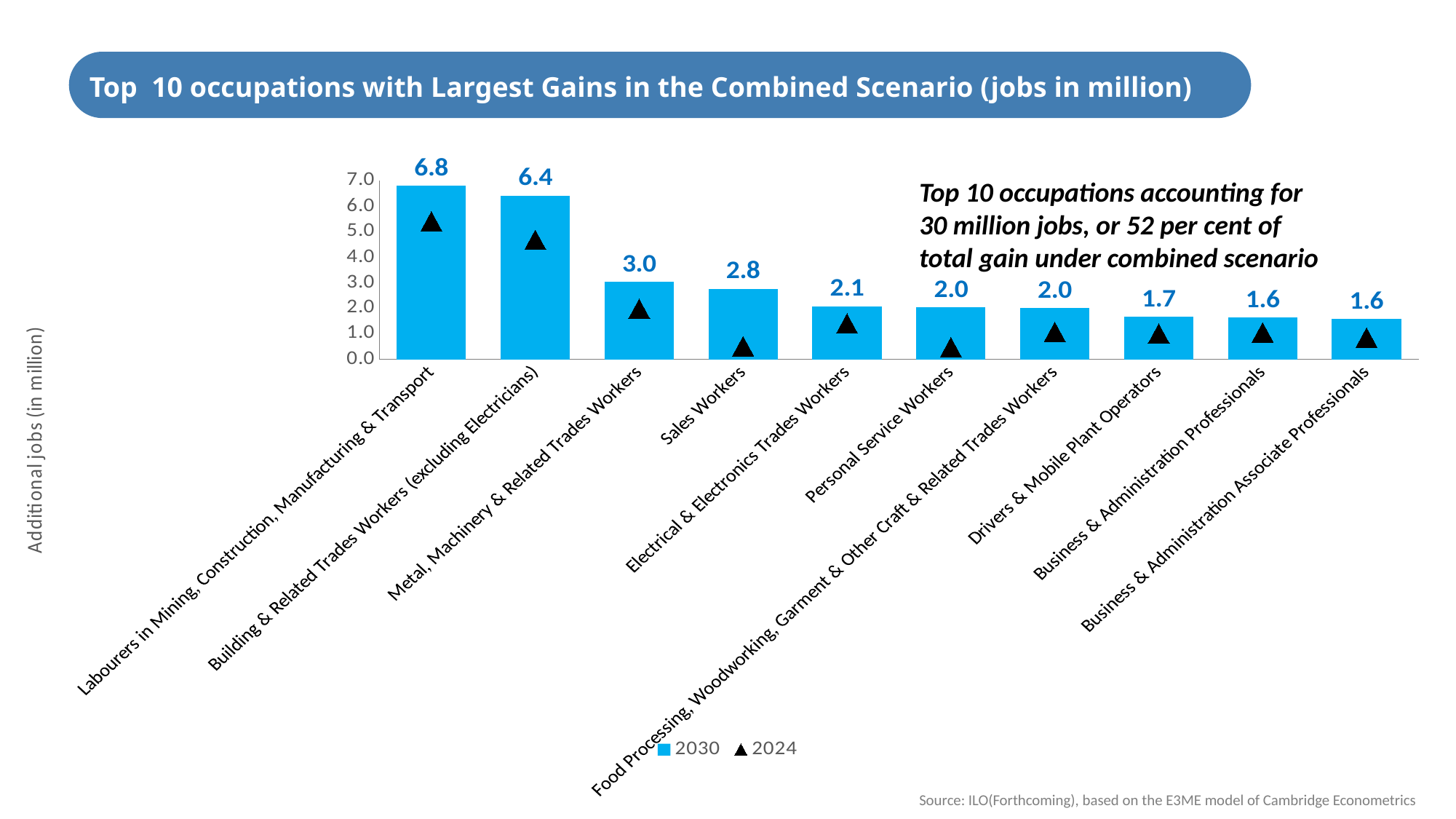
Is the 2024 value for Sales Workers greater or less than 1.0? less How many occupations are shown on the chart? 10 What is the 2030 value for Drivers & Mobile Plant Operators? 1.7 What is the label on the vertical axis? Additional jobs (in million) What is the 2030 value for Building & Related Trades Workers (excluding Electricians)? 6.4 Which has a larger 2030 value, Sales Workers or Electrical & Electronics Trades Workers? Sales Workers Which occupation has the highest 2030 value? Labourers in Mining, Construction, Manufacturing & Transport What kind of chart is this? bar chart What is the 2030 value for Sales Workers? 2.8 What is the difference between the 2030 values for Labourers in Mining, Construction, Manufacturing & Transport and Metal, Machinery & Related Trades Workers? 3.8 How many series does the legend list? 2 Is the 2024 value for Building & Related Trades Workers (excluding Electricians) greater or less than 4.0? greater